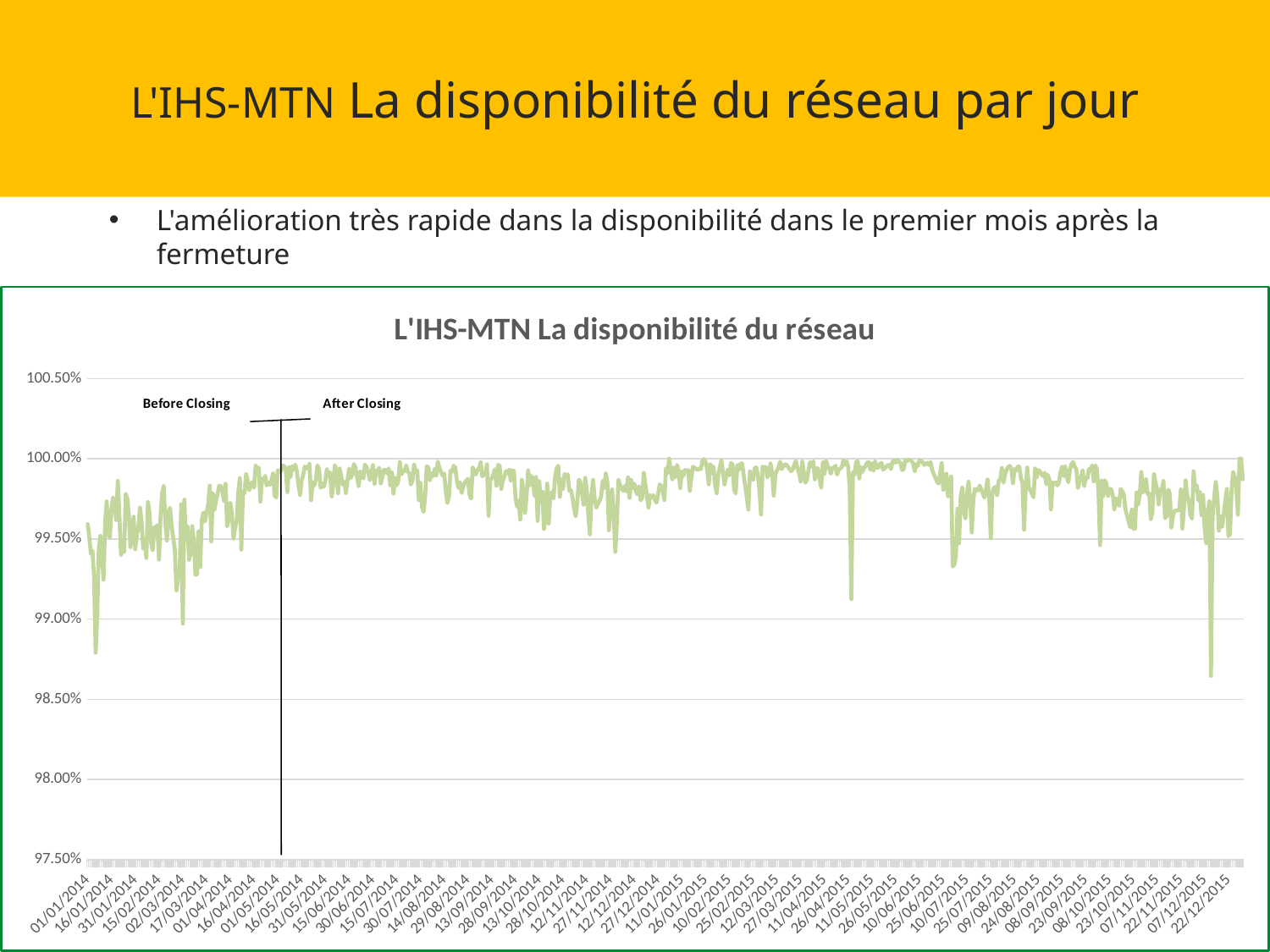
What is the title of the chart? L'IHS-MTN La disponibilité du réseau Does the line ever go above 100.00% on the chart? No Is the lowest dip in the line during December 2015 greater or less than 99.00%? less Is the lowest dip in the line during January 2014 greater or less than 99.00%? less What two annotations label the periods on either side of the vertical line in the chart? Before Closing and After Closing What is the highest value shown on the y axis of the chart? 100.50% Does the network availability generally rise or fall in the first months after the closing line? rise What is the last date shown on the x axis of the chart? 22/12/2015 What is the lowest value shown on the y axis of the chart? 97.50% What is the first date shown on the x axis of the chart? 01/01/2014 What kind of chart is shown on the slide? line chart